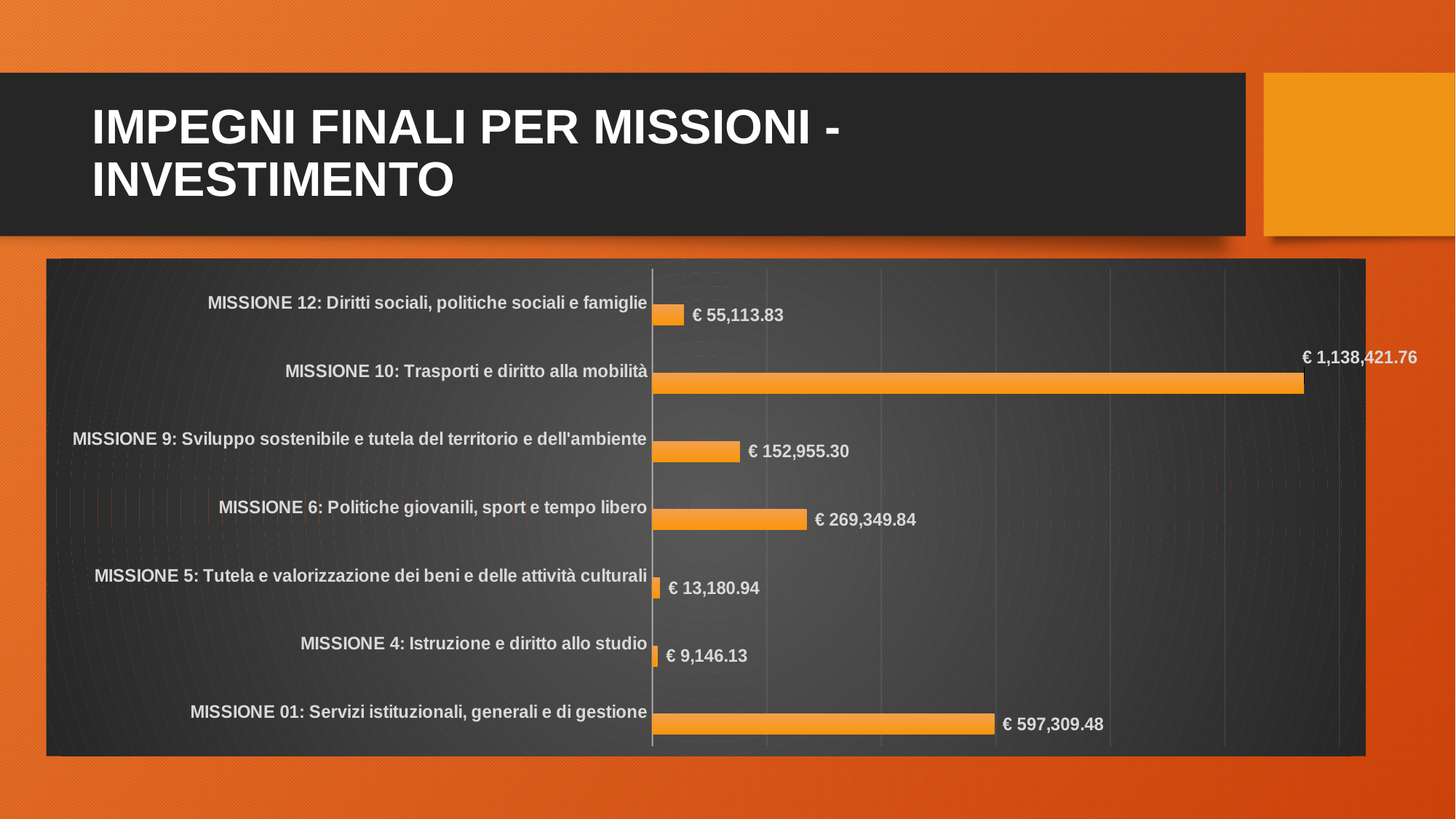
What is the difference between the values for MISSIONE 10 and MISSIONE 01? € 541,112.28 Which is larger, the value for MISSIONE 9 or the value for MISSIONE 12? MISSIONE 9 Which mission has the highest value? MISSIONE 10: Trasporti e diritto alla mobilità What kind of chart is shown on the slide? Bar chart What is the difference between the values for MISSIONE 6 and MISSIONE 9? € 116,394.54 What is the value for MISSIONE 12: Diritti sociali, politiche sociali e famiglie? € 55,113.83 Which is larger, the value for MISSIONE 5 or the value for MISSIONE 4? MISSIONE 5 What is the value for MISSIONE 4: Istruzione e diritto allo studio? € 9,146.13 Which mission has the lowest value? MISSIONE 4: Istruzione e diritto allo studio What is the value for MISSIONE 10: Trasporti e diritto alla mobilità? € 1,138,421.76 How many missions are shown in the chart? 7 What is the value for MISSIONE 6: Politiche giovanili, sport e tempo libero? € 269,349.84